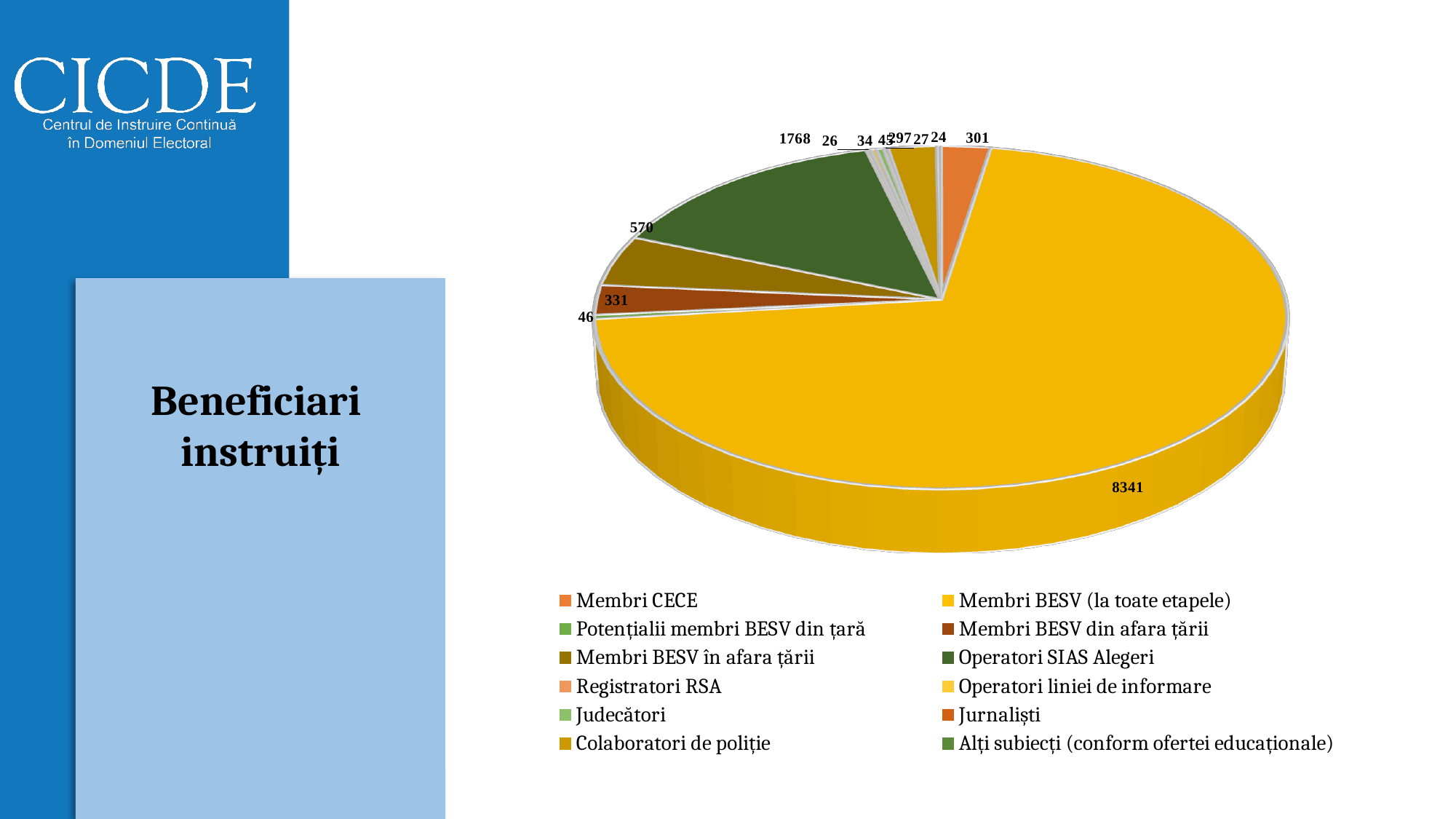
What is the value for Membri BESV în afara țării? 570 Which is larger, the value for Operatori SIAS Alegeri or the value for Membri CECE? Operatori SIAS Alegeri What is the value for Membri CECE? 301 Which category has the largest slice of the pie? Membri BESV (la toate etapele) What is the difference between the values for Operatori SIAS Alegeri and Membri BESV în afara țării? 1198 How many entries does the legend list? 12 What is the value for Potențialii membri BESV din țară? 46 What is the title shown next to the chart on the slide? Beneficiari instruiți What is the value for Membri BESV din afara țării? 331 What is the value for Operatori SIAS Alegeri? 1768 What is the value for Membri BESV (la toate etapele)? 8341 What kind of chart is shown on the slide? pie chart